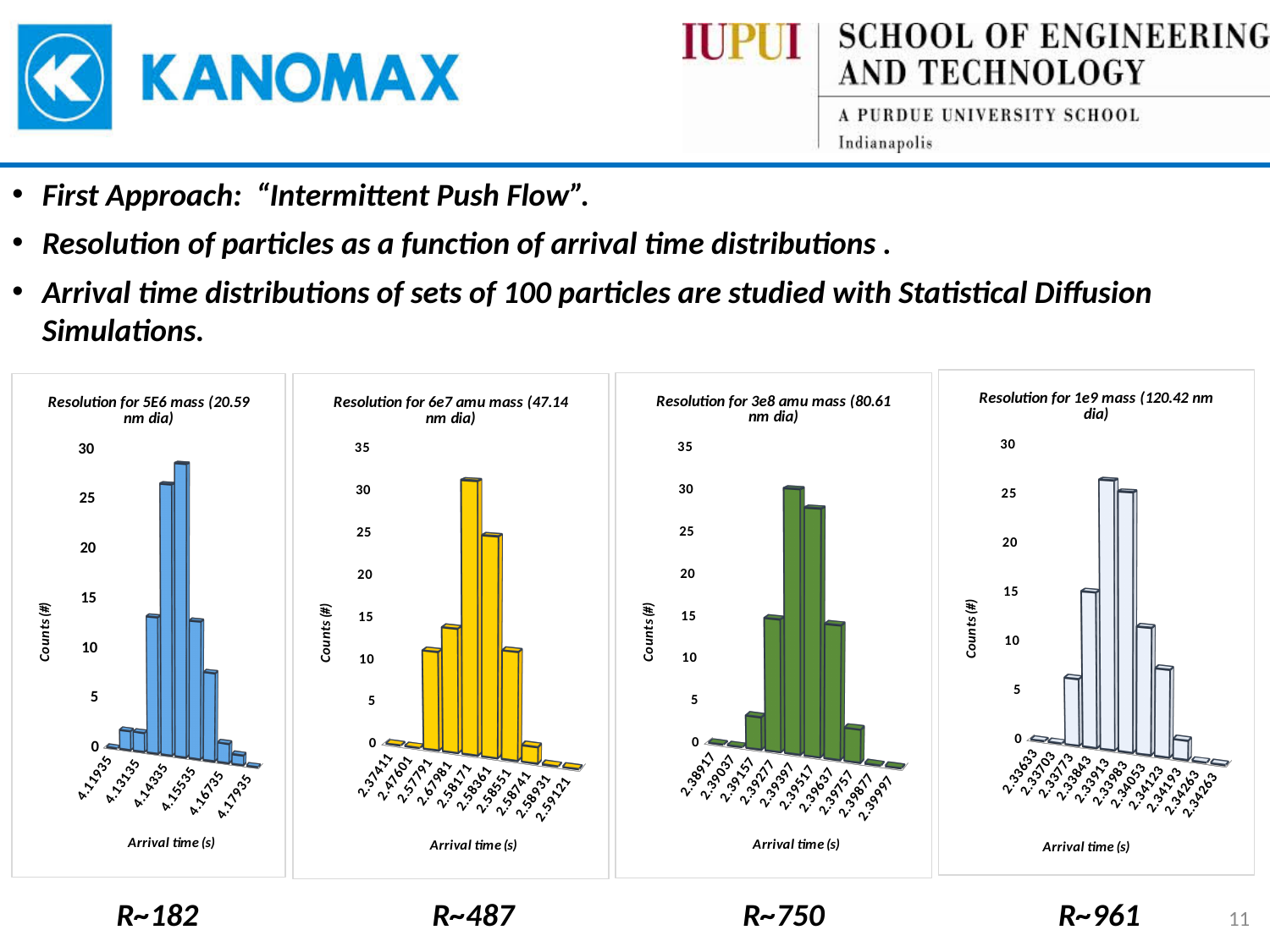
In the chart 'Resolution for 6e7 amu mass (47.14 nm dia)', is the tallest bar greater or less than 25? greater What is the x-axis label of the chart 'Resolution for 1e9 mass (120.42 nm dia)'? Arrival time (s) How many charts are shown on the slide? 4 In the chart 'Resolution for 3e8 amu mass (80.61 nm dia)', is the tallest bar greater or less than 35? less In the chart 'Resolution for 1e9 mass (120.42 nm dia)', is the tallest bar greater or less than 20? greater What kind of chart is 'Resolution for 5E6 mass (20.59 nm dia)'? bar chart What is the y-axis label of the chart 'Resolution for 5E6 mass (20.59 nm dia)'? Counts (#)